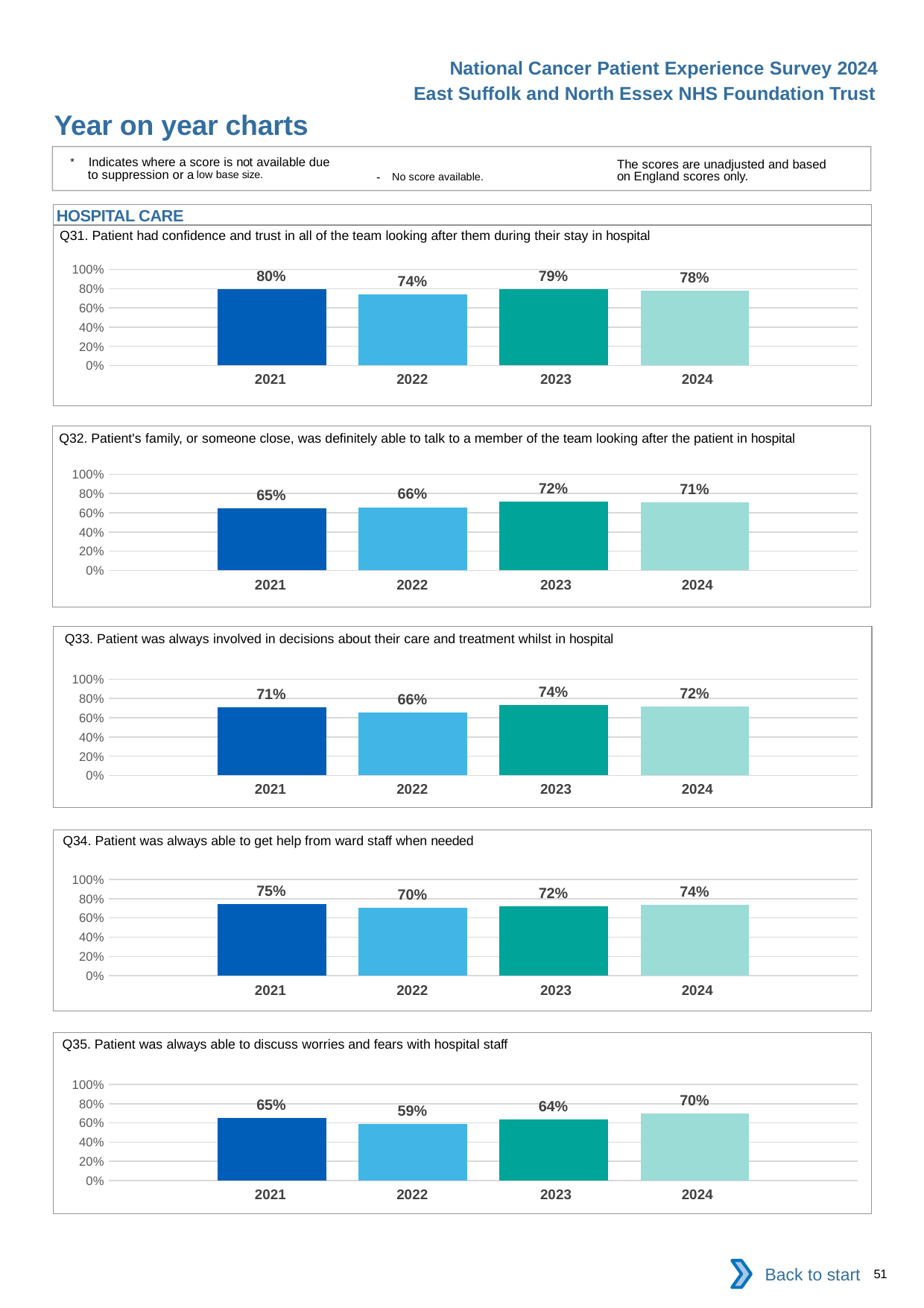
How many years are shown in the Q35 chart? 4 In the Q31 chart, which year has the highest value? 2021 In the Q31 chart, what is the value for 2022? 74% In the Q33 chart, is the value for 2021 larger or the value for 2024? 2024 In the Q34 chart, what is the difference between the 2021 and 2022 values? 5 percentage points In the Q32 chart, which year has the lowest value? 2021 What type of chart is the Q31 chart? Bar chart In the Q32 chart, what is the difference between the 2023 and 2021 values? 7 percentage points In the Q33 chart, which year has the highest value? 2023 In the Q35 chart, which year has the lowest value? 2022 In the Q34 chart, what is the value for 2021? 75% In the Q32 chart, what is the value for 2024? 71%